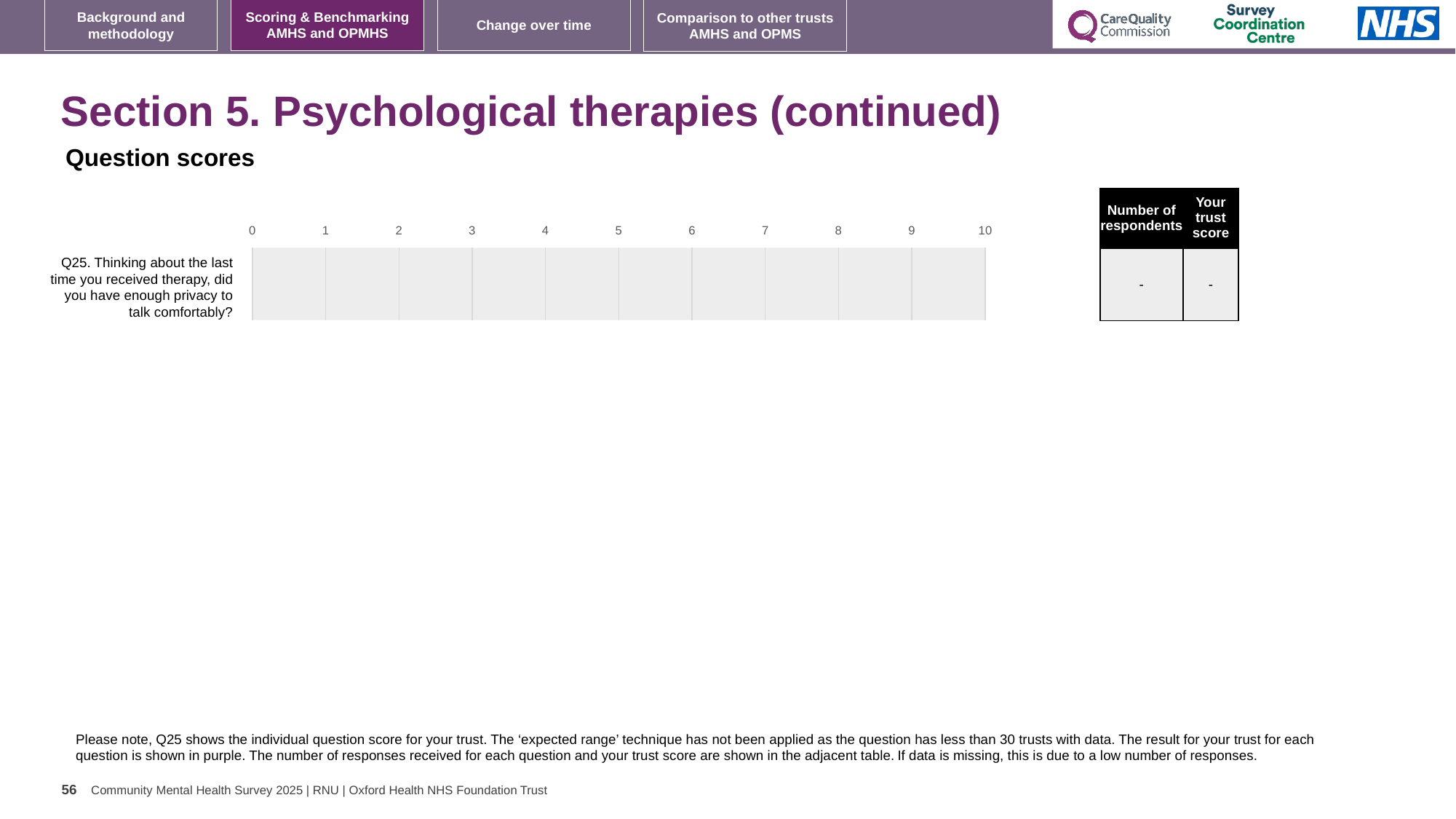
What is shown in the 'Number of respondents' column of the table for Q25? - How many questions (categories) are plotted on the chart? 1 What kind of chart is used to show the question scores? bar chart What is shown in the 'Your trust score' column of the table for Q25? - What is the lowest value shown on the chart's axis? 0 Which question number is plotted on the chart? Q25 What is the highest value shown on the chart's axis? 10